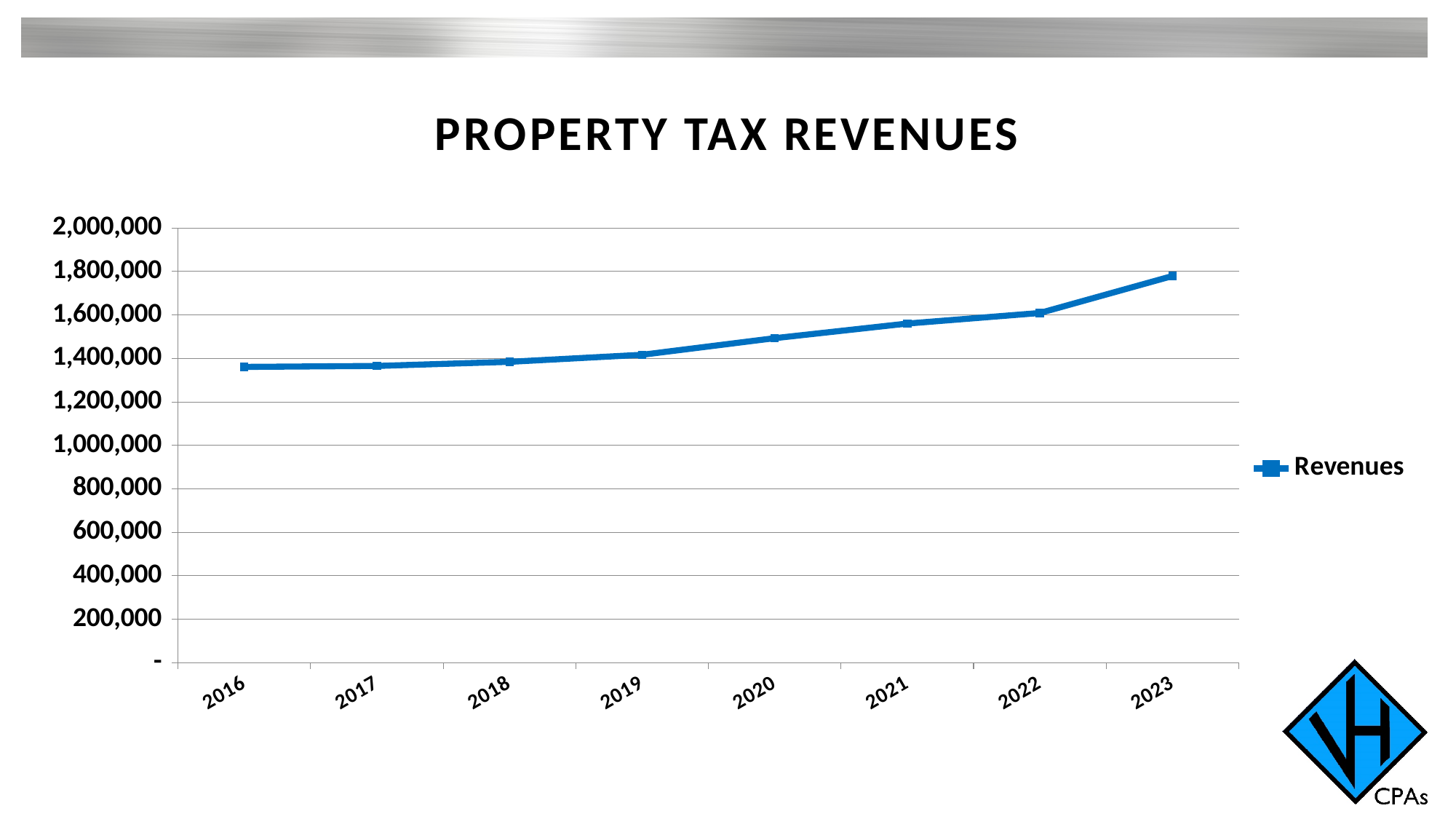
How many years are plotted on the x axis? 8 Is the value for 2021 greater or less than 1,400,000? greater Which year has larger revenues, 2016 or 2023? 2023 Which year has larger revenues, 2018 or 2021? 2021 What is the name of the series shown in the legend? Revenues Which year has the highest revenues? 2023 How many series does the legend list? 1 What kind of chart is shown on the slide? line chart Do revenues rise or fall from 2016 to 2023? rise What is the title of the chart? PROPERTY TAX REVENUES Is the value for 2016 greater or less than 1,400,000? less Is the value for 2023 greater or less than 1,600,000? greater